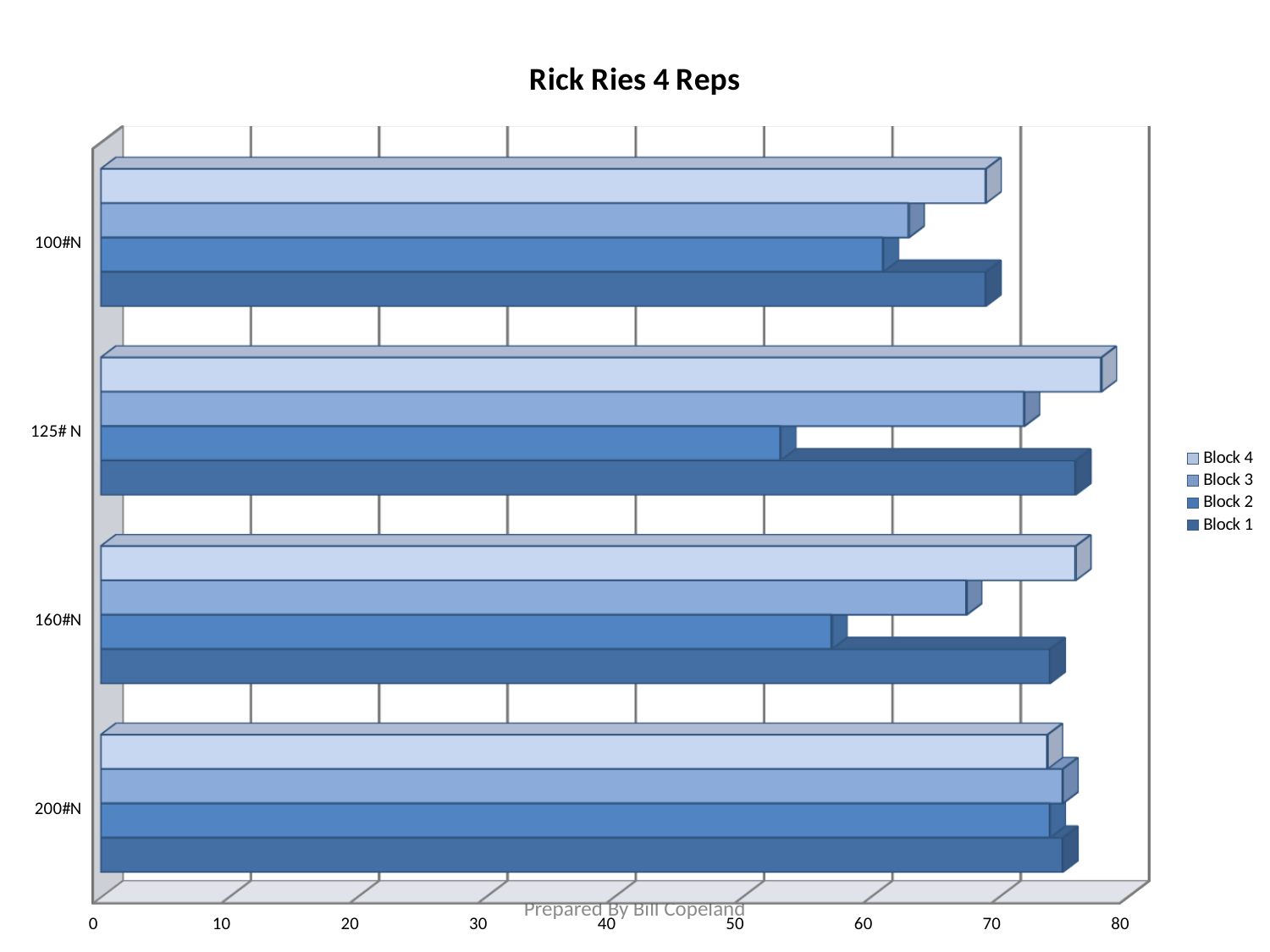
How many categories are shown on the vertical axis? 4 How many series does the legend list? 4 What is the title of the chart? Rick Ries 4 Reps Is the value for Block 1 at 125# N greater or less than 70? greater Which series are listed in the legend? Block 4, Block 3, Block 2, Block 1 For 160#N, which is larger: Block 1 or Block 2? Block 1 Is the value for Block 2 at 125# N greater or less than 60? less Is the value for Block 2 at 160#N greater or less than 60? less What kind of chart is shown on the slide? bar chart For 125# N, which series has the lowest value? Block 2 For 125# N, which is larger: Block 4 or Block 2? Block 4